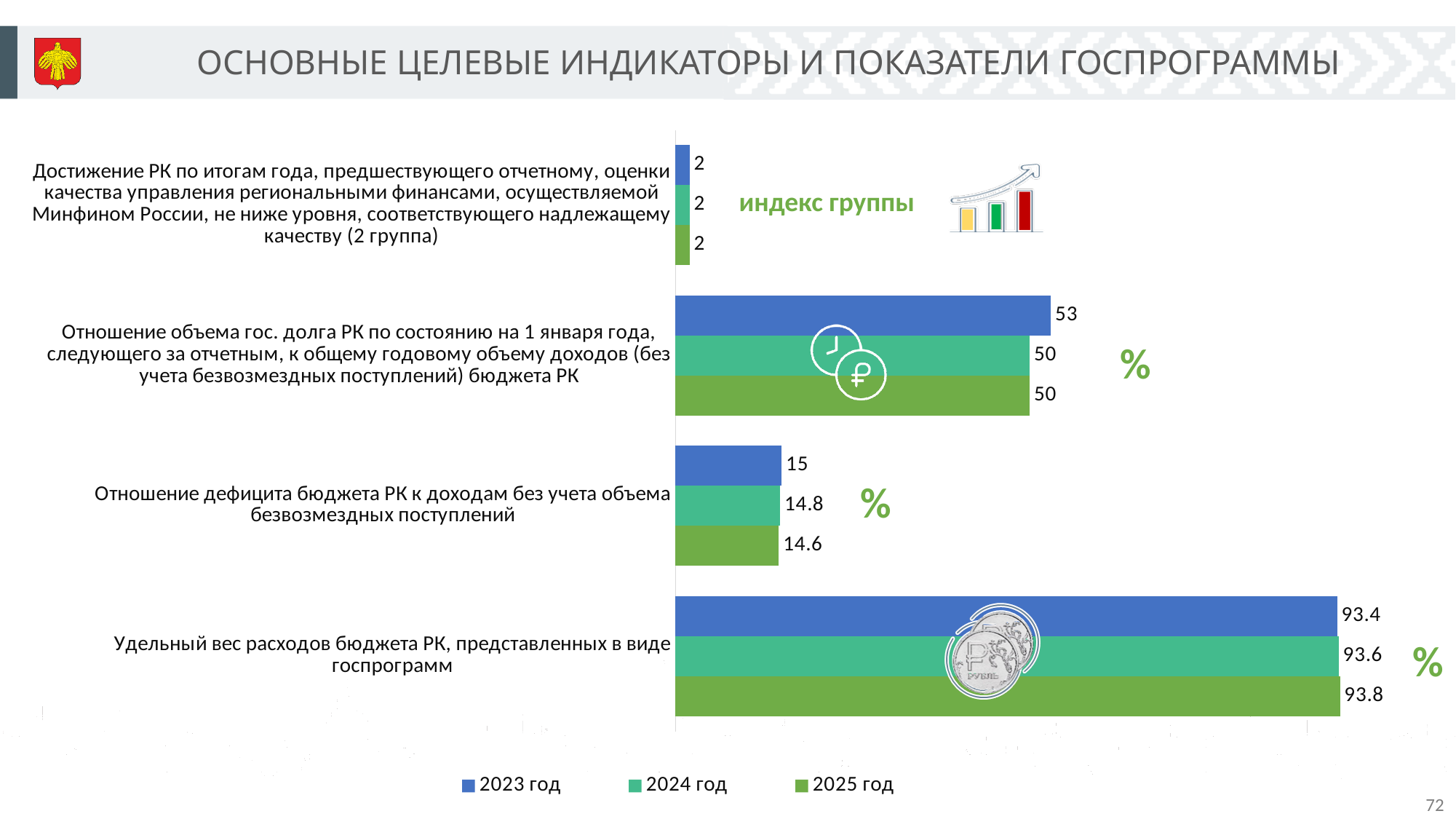
What is the value for 2024 год for the category 'Отношение объема гос. долга РК по состоянию на 1 января года, следующего за отчетным, к общему годовому объему доходов (без учета безвозмездных поступлений) бюджета РК'? 50 Which year has the lowest value for 'Отношение дефицита бюджета РК к доходам без учета объема безвозмездных поступлений'? 2025 год For 'Удельный вес расходов бюджета РК, представленных в виде госпрограмм', which is larger: the 2023 год value or the 2025 год value? 2025 год Which legend entry is shown in blue? 2023 год What is the value for 2023 год for the category about achieving the Minfin quality-of-regional-finance-management assessment (2 группа)? 2 What kind of chart is shown on the slide? Bar chart What is the difference between the 2023 год and 2024 год values for the state debt ratio category ('Отношение объема гос. долга РК...')? 3 How many categories are shown on the chart? 4 How many series does the legend list? 3 What is the value for 2025 год for the category 'Отношение дефицита бюджета РК к доходам без учета объема безвозмездных поступлений'? 14.6 Which year has the highest value for 'Удельный вес расходов бюджета РК, представленных в виде госпрограмм'? 2025 год What is the value for 2023 год for the category 'Удельный вес расходов бюджета РК, представленных в виде госпрограмм'? 93.4